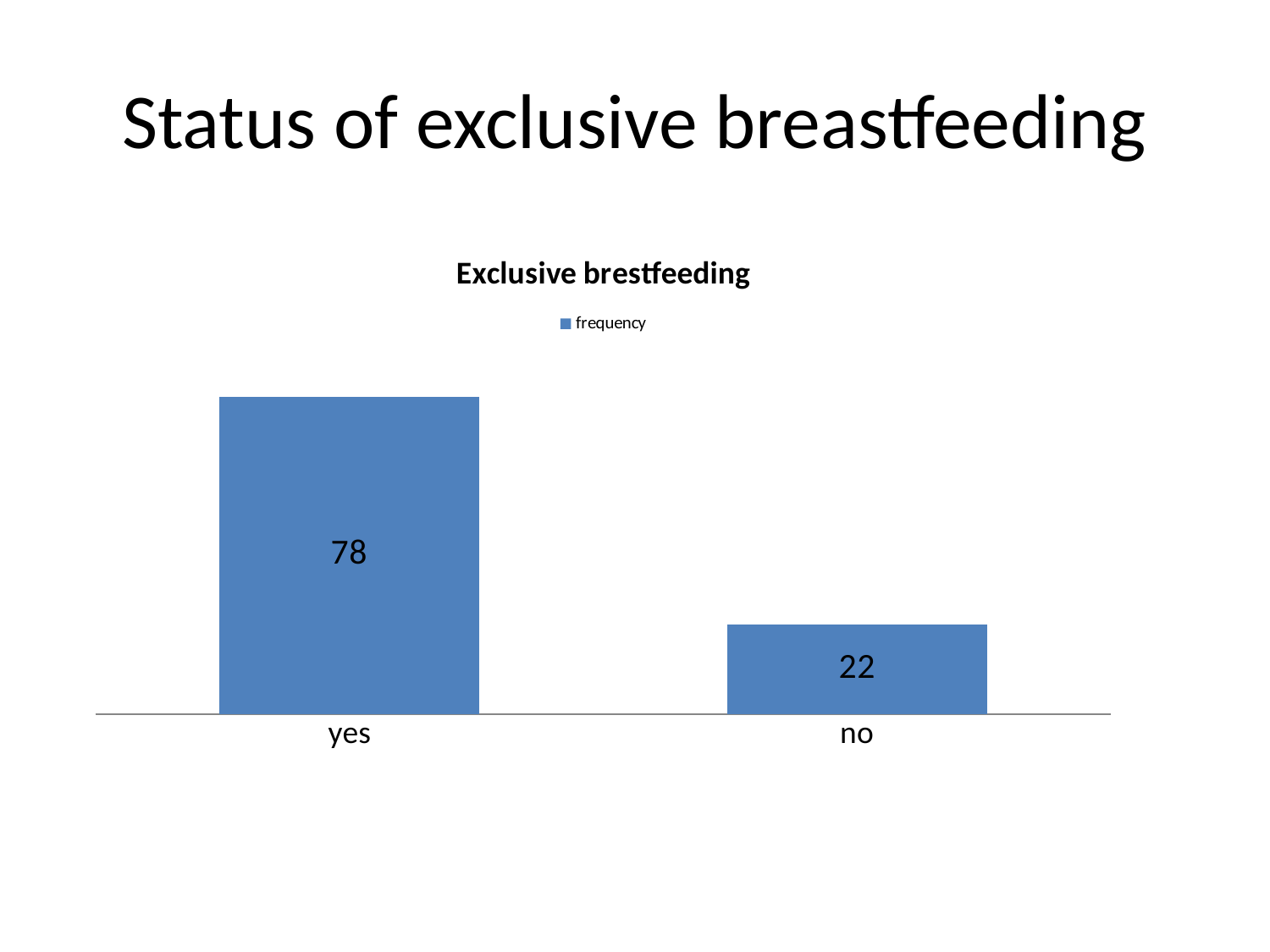
What is the title of the chart? Exclusive brestfeeding Which has a larger frequency, "yes" or "no"? yes What series name is shown in the legend? frequency How many series does the legend list? 1 How many categories are shown on the x axis? 2 What is the frequency for "yes"? 78 What is the frequency for "no"? 22 What is the difference between the frequency for "yes" and the frequency for "no"? 56 Which category has the lowest frequency? no What kind of chart is shown on the slide? bar chart What is the total of the frequencies for "yes" and "no"? 100 Which category has the highest frequency? yes